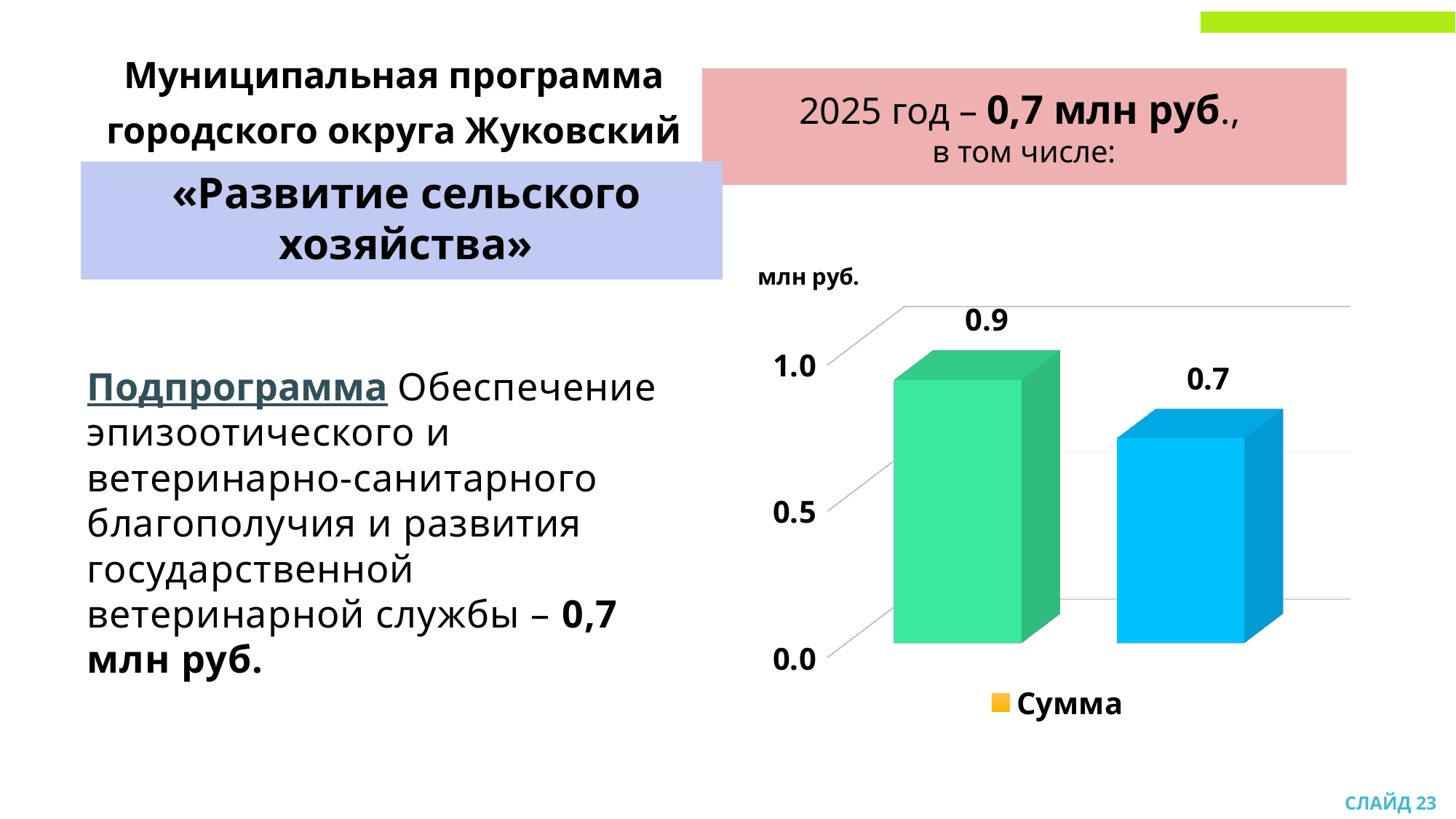
What is the value shown on the left (green) bar of the chart? 0.9 Is the value of the right blue bar larger or smaller than the value of the left green bar? smaller How many series does the chart legend list? 1 How many bars are plotted in the chart? 2 Is the value for the left green bar greater or less than 0.5? greater Which bar has the lower value, the left green bar or the right blue bar? the right blue bar What kind of chart is shown on the slide? bar chart What is the difference between the values of the left bar and the right bar? 0.2 What is the value shown on the right (blue) bar of the chart? 0.7 Do the bar values rise or fall from left to right? fall What is the name of the series shown in the chart legend? Сумма Which bar has the higher value, the left green bar or the right blue bar? the left green bar